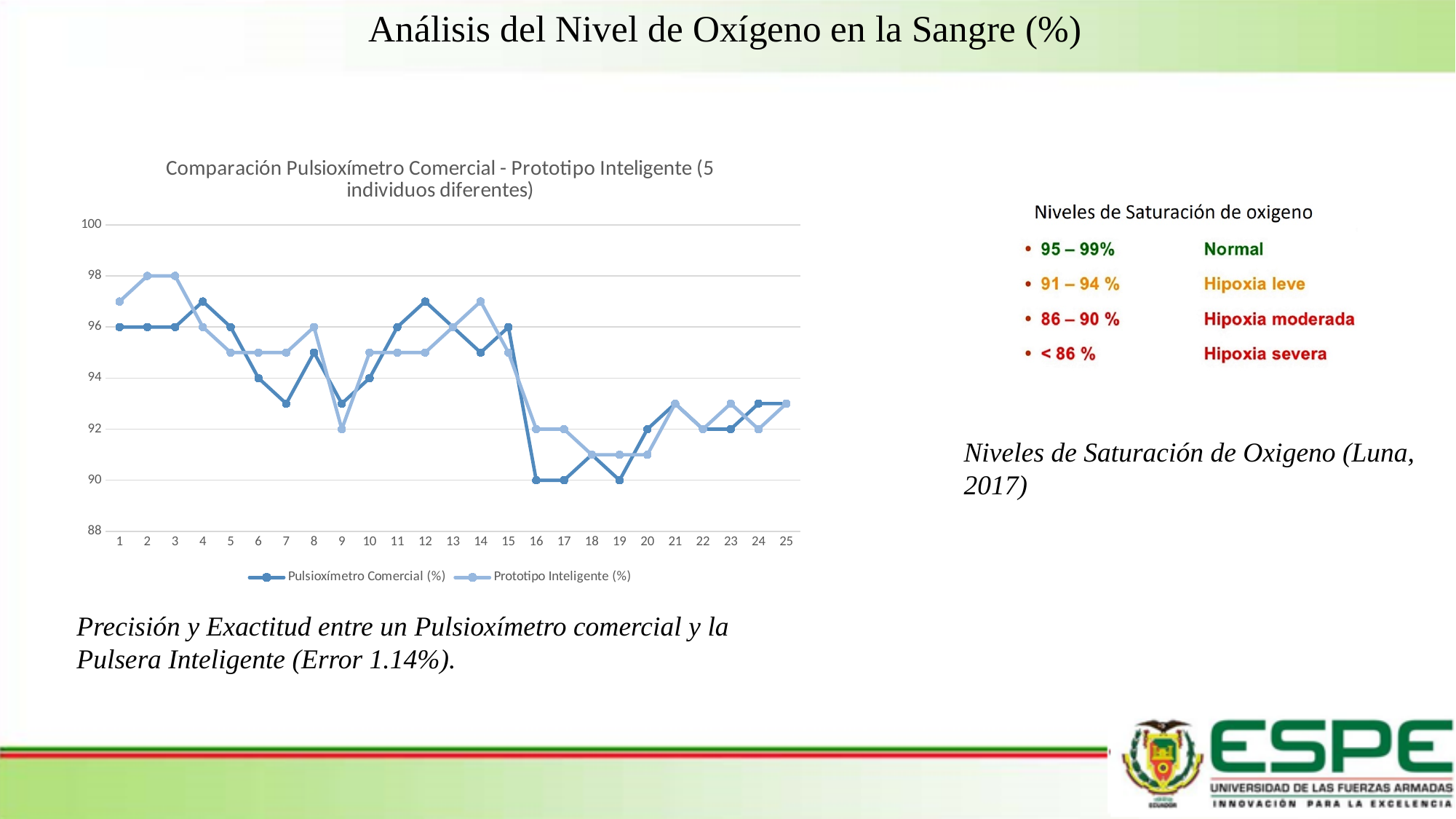
At point 2, what is the difference between Prototipo Inteligente (%) and Pulsioxímetro Comercial (%)? 2 What is the value of Prototipo Inteligente (%) at point 2? 98 How many series does the chart legend list? 2 What is the value of Pulsioxímetro Comercial (%) at point 1? 96 What is the lowest value reached by the Pulsioxímetro Comercial (%) series? 90 What is the value of Pulsioxímetro Comercial (%) at point 16? 90 At point 2, which series has the higher value? Prototipo Inteligente (%) Do both series rise or fall between point 15 and point 16? fall What kind of chart is shown on the slide? line chart How many points are plotted along the x axis of the chart? 25 Is the value for Pulsioxímetro Comercial (%) at point 12 greater or less than 96? greater What is the highest value reached by the Prototipo Inteligente (%) series? 98